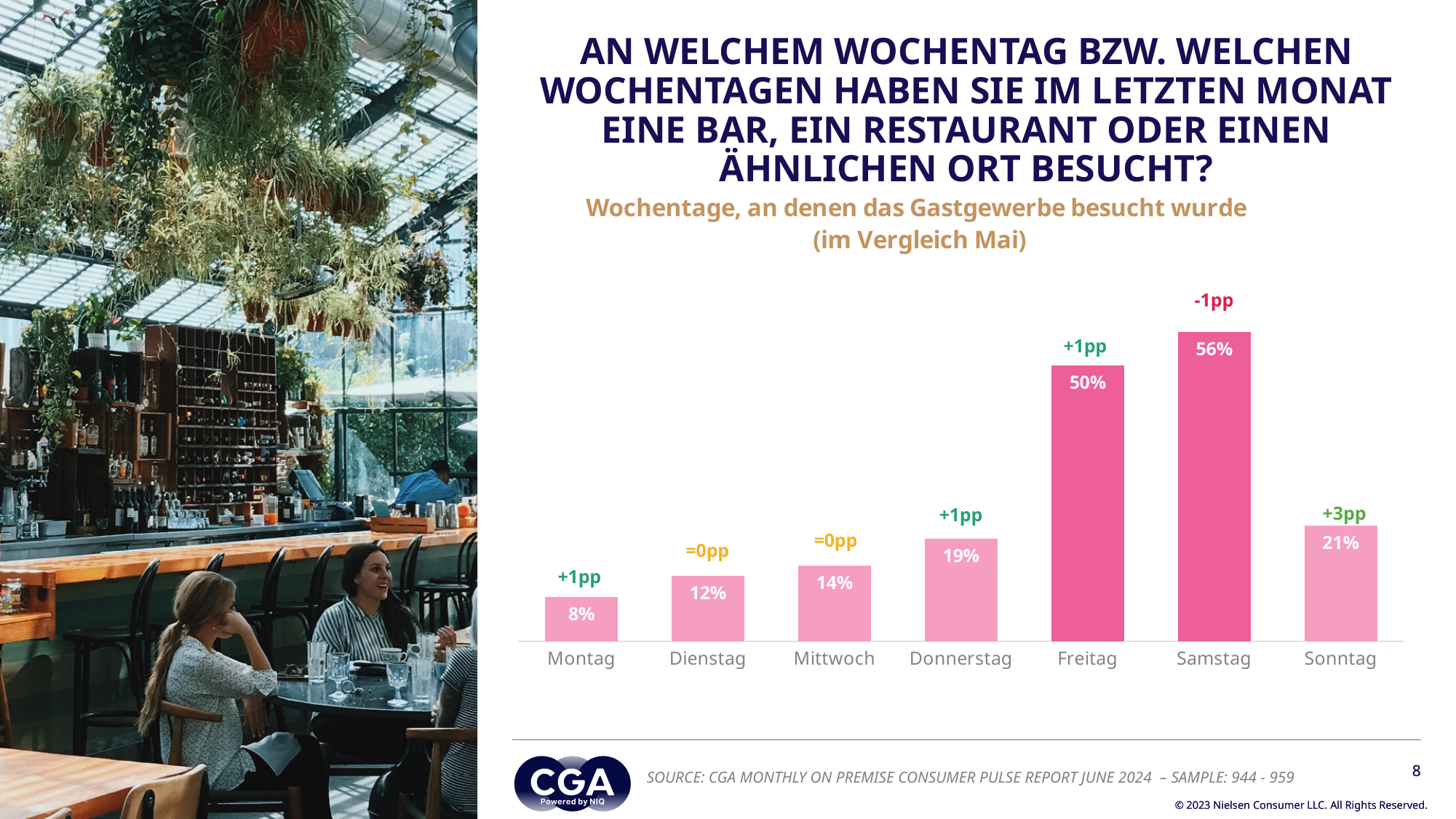
What change versus May is shown above the Sonntag bar? +3pp What is the difference between the values for Samstag and Freitag? 6% What is the value for Donnerstag? 19% What change versus May is shown above the Samstag bar? -1pp What is the value for Montag? 8% What kind of chart is shown on the slide? Bar chart Which weekday has the lowest value? Montag Which weekday has the highest value? Samstag What is the difference between the values for Sonntag and Mittwoch? 7% What is the value for Samstag? 56% Which is larger, the value for Dienstag or the value for Sonntag? Sonntag How many weekdays are shown on the chart? 7